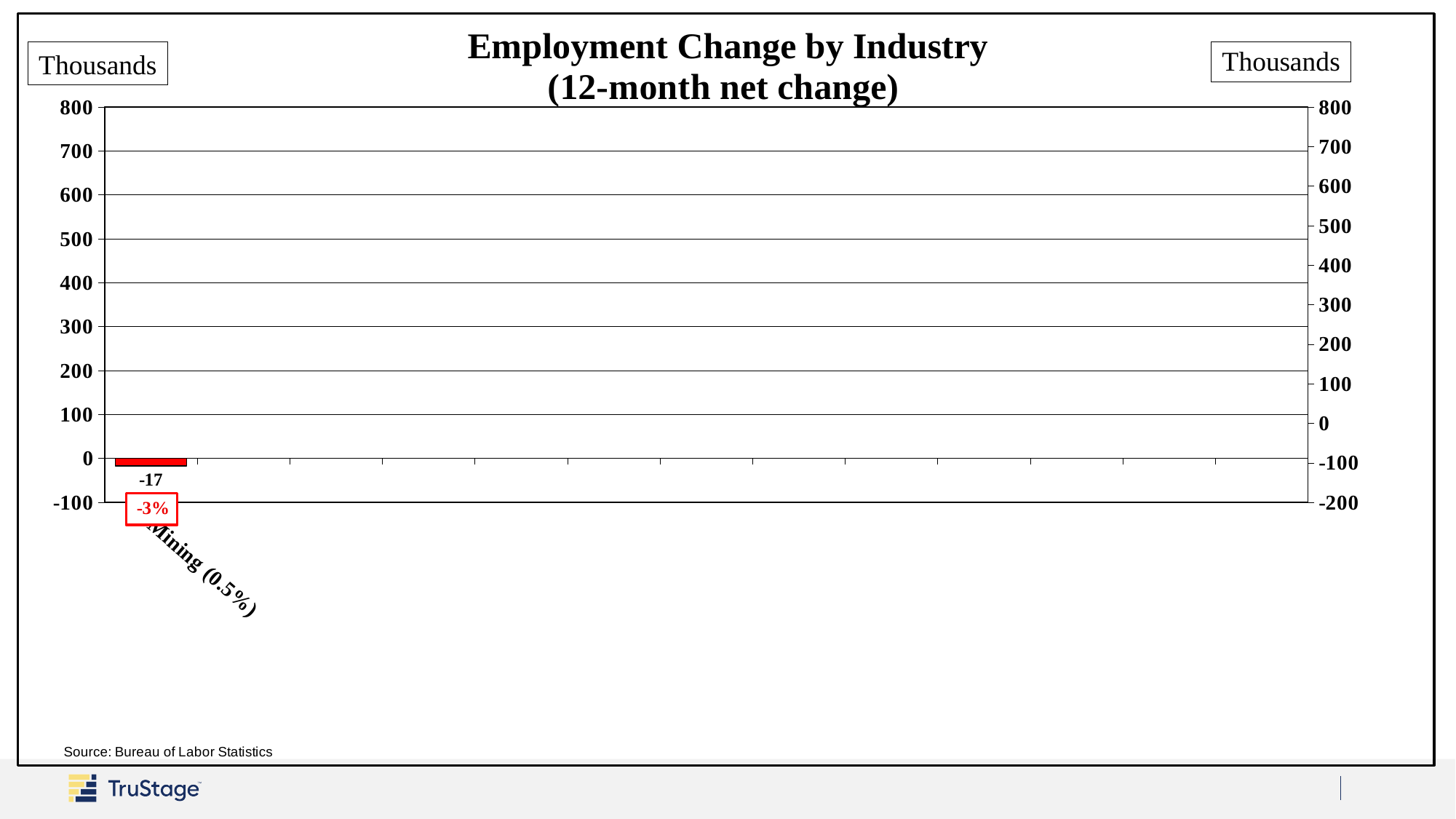
What is the title of the chart? Employment Change by Industry (12-month net change) Is the value for Mining (0.5%) greater or less than 0? less What percentage label is shown in red below the Mining (0.5%) bar? -3% What is the 12-month net employment change shown for Mining (0.5%)? -17 What colour is the bar for Mining (0.5%)? red What is the highest value shown on the left vertical axis? 800 What unit is indicated in the boxes at the top left and top right of the chart? Thousands Is the value for Mining (0.5%) greater or less than 100? less What is the lowest value shown on the right vertical axis? -200 What kind of chart is shown on the slide? bar chart